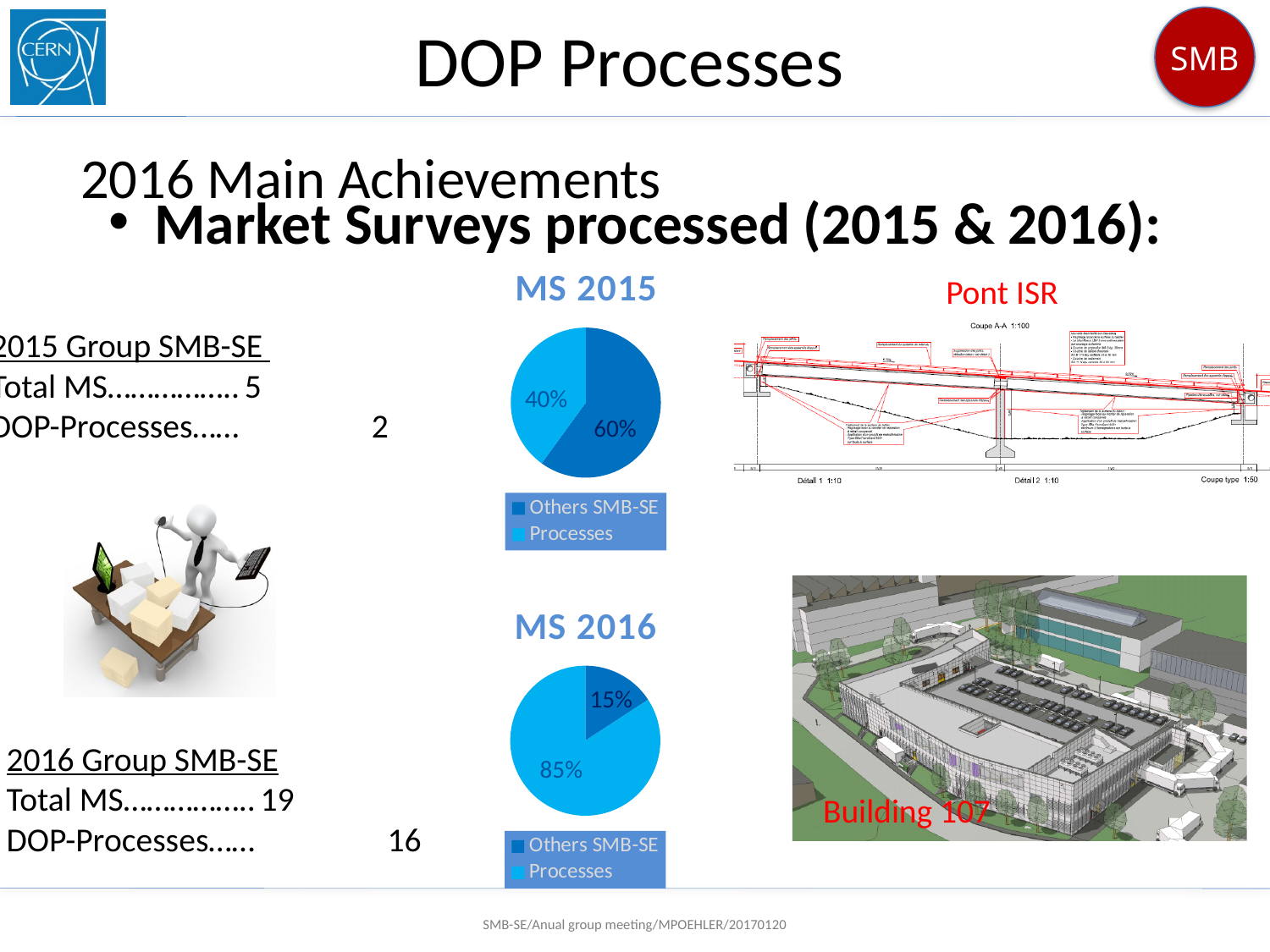
In the MS 2016 chart, which slice is the smallest? Others SMB-SE In the MS 2015 chart, which slice is the largest? Others SMB-SE How many slices does the MS 2016 pie chart have? 2 In the MS 2016 chart, what is the difference between the Processes share and the Others SMB-SE share? 70% What kind of chart is the MS 2016 chart? Pie chart In the MS 2015 chart, what is the difference between the Others SMB-SE share and the Processes share? 20% How many entries does the legend of the MS 2015 chart list? 2 In the MS 2016 chart, what share of the pie is Others SMB-SE? 15% In the MS 2015 chart, what share of the pie is Others SMB-SE? 60% In the MS 2015 chart, which is larger: Processes or Others SMB-SE? Others SMB-SE In the MS 2016 chart, what share of the pie is Processes? 85% In the MS 2015 chart, what share of the pie is Processes? 40%